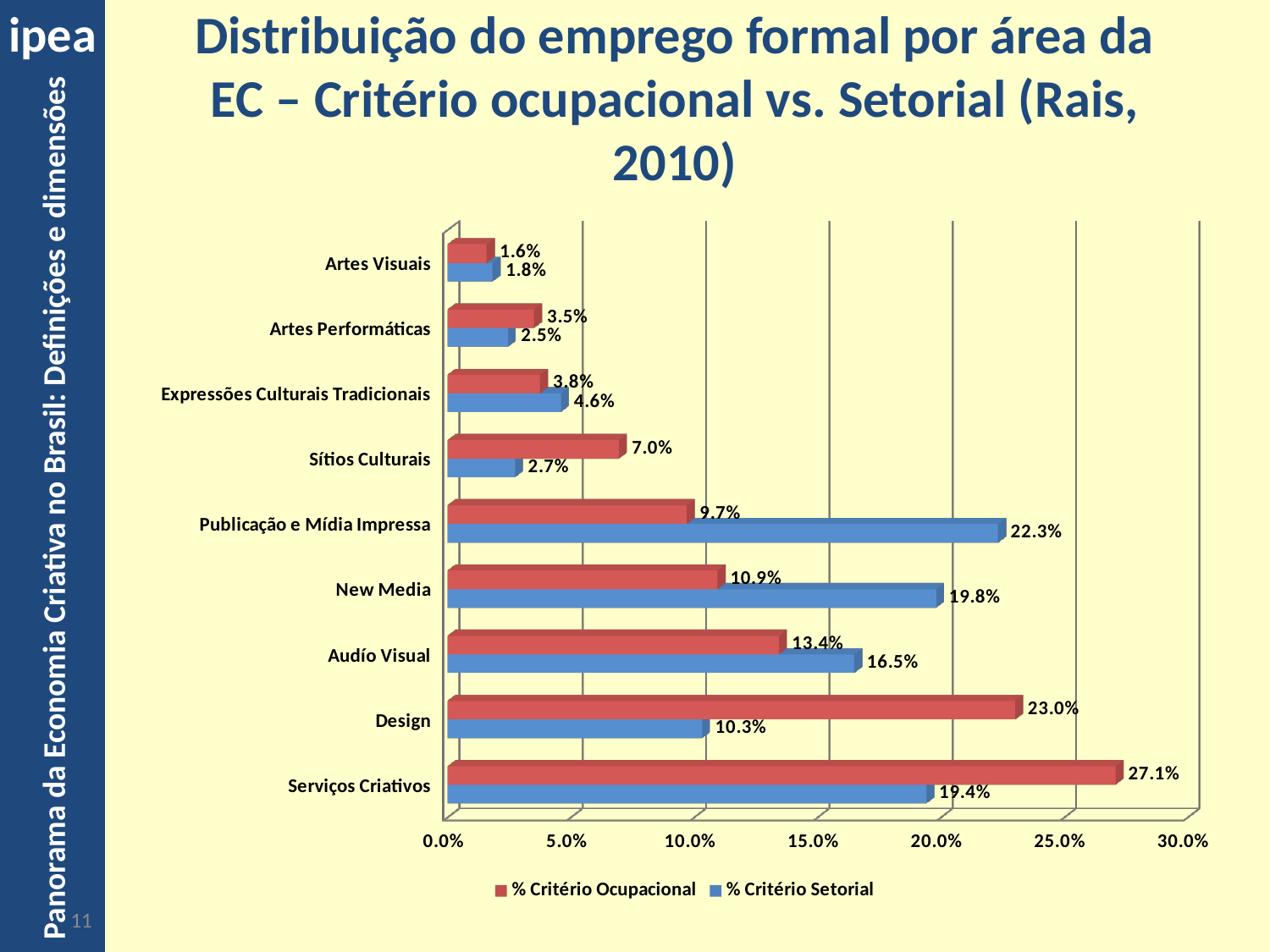
How many series does the legend list? 2 Which category has the lowest % Critério Setorial value? Artes Visuais Which category has the highest % Critério Ocupacional value? Serviços Criativos For New Media, which is larger: % Critério Ocupacional or % Critério Setorial? % Critério Setorial What kind of chart is shown on the slide? Bar chart What is the % Critério Setorial value for Publicação e Mídia Impressa? 22.3% How many categories are shown on the chart? 9 What is the difference between the % Critério Ocupacional and % Critério Setorial values for Design? 12.7% What is the % Critério Ocupacional value for Sítios Culturais? 7.0% Which colour represents the % Critério Setorial series? Blue What is the % Critério Ocupacional value for Serviços Criativos? 27.1% What is the % Critério Setorial value for Design? 10.3%